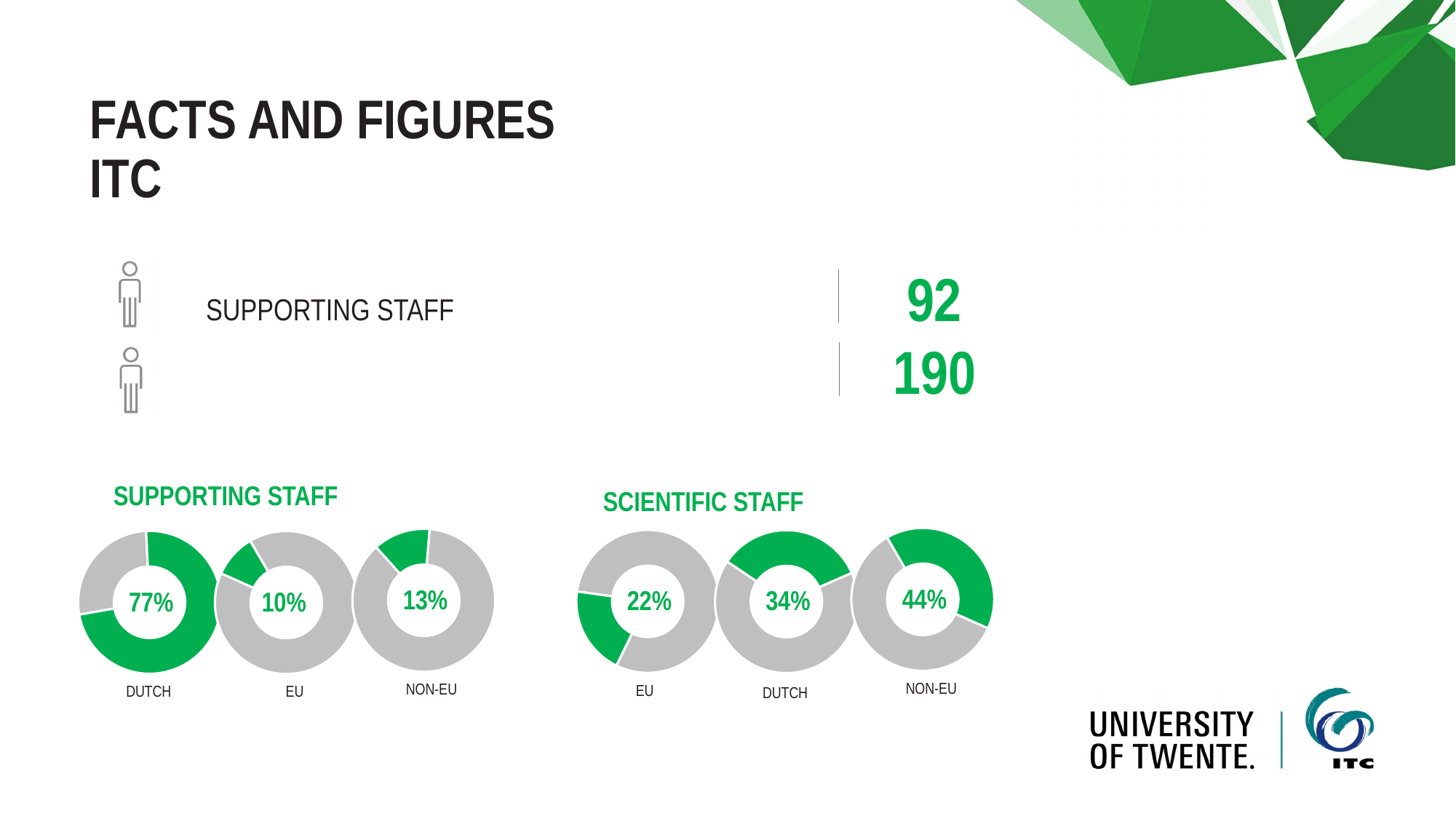
In the Scientific Staff charts, what percentage is shown for Dutch? 34% In the Scientific Staff charts, what percentage is shown for EU? 22% What kind of chart is used to show the Supporting Staff and Scientific Staff percentages? Donut chart In the Supporting Staff charts, what percentage is shown for Dutch? 77% In the Supporting Staff charts, which category has the lowest percentage? EU In the Supporting Staff charts, what percentage is shown for Non-EU? 13% In the Scientific Staff charts, which category has the highest percentage? Non-EU In the Scientific Staff charts, what percentage is shown for Non-EU? 44% In the Supporting Staff charts, what percentage is shown for EU? 10% Which is larger: the Non-EU percentage for Supporting Staff or the Non-EU percentage for Scientific Staff? Scientific Staff What is the difference between the Dutch percentage for Supporting Staff and the Dutch percentage for Scientific Staff? 43% How many donut charts are shown under the Scientific Staff heading? 3